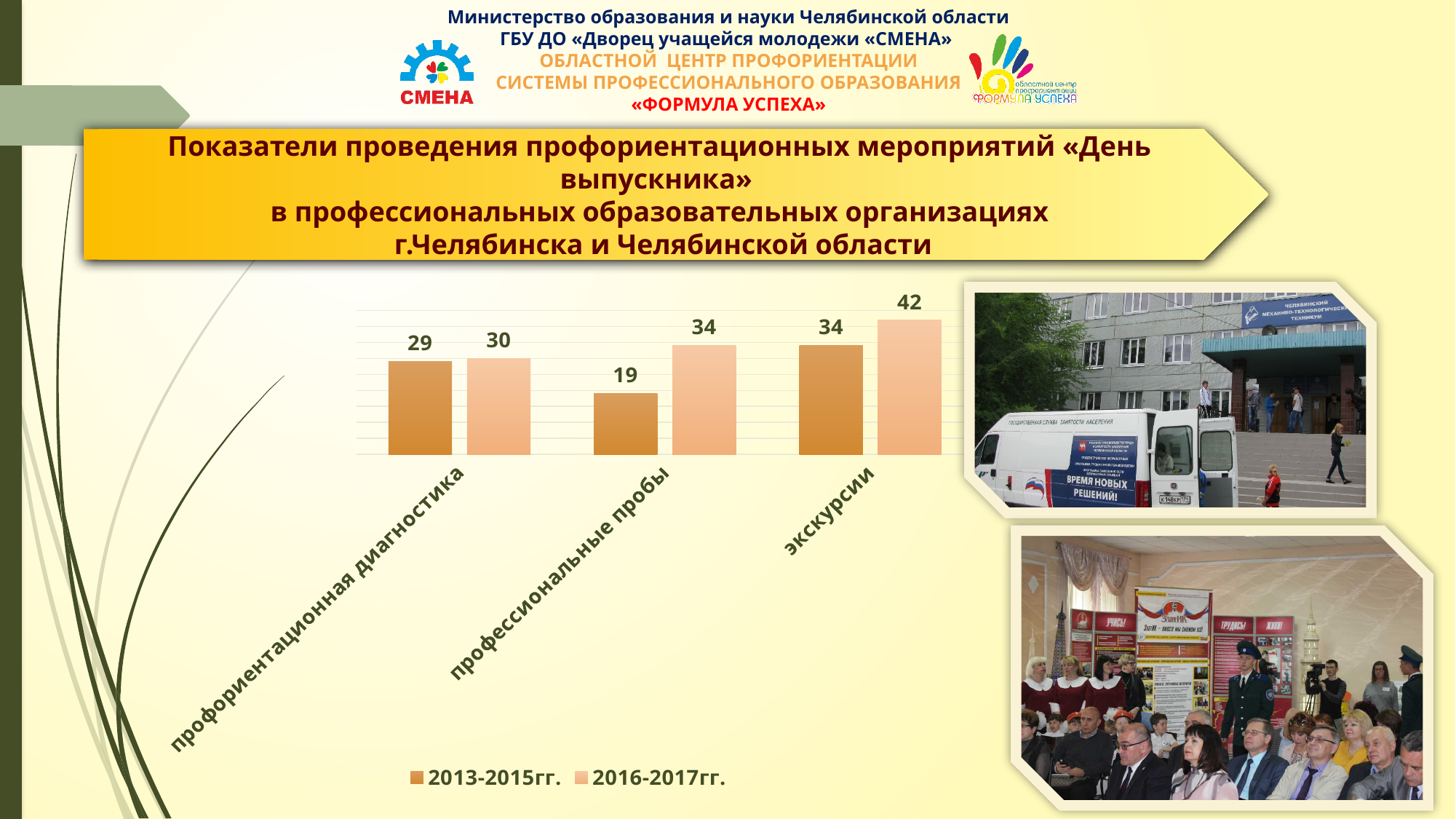
What is the value for экскурсии in the 2016-2017гг. series? 42 What is the difference between the 2016-2017гг. and 2013-2015гг. values for экскурсии? 8 What is the difference between the 2016-2017гг. and 2013-2015гг. values for профессиональные пробы? 15 What is the value for профессиональные пробы in the 2016-2017гг. series? 34 Which category has the lowest value in the 2013-2015гг. series? профессиональные пробы Which category has the highest value in the 2016-2017гг. series? экскурсии How many series does the legend list? 2 How many categories are shown on the x axis of the chart? 3 What kind of chart is shown on the slide? bar chart What is the value for профориентационная диагностика in the 2013-2015гг. series? 29 Which is larger for профориентационная диагностика: the 2013-2015гг. value or the 2016-2017гг. value? 2016-2017гг. What is the value for профессиональные пробы in the 2013-2015гг. series? 19